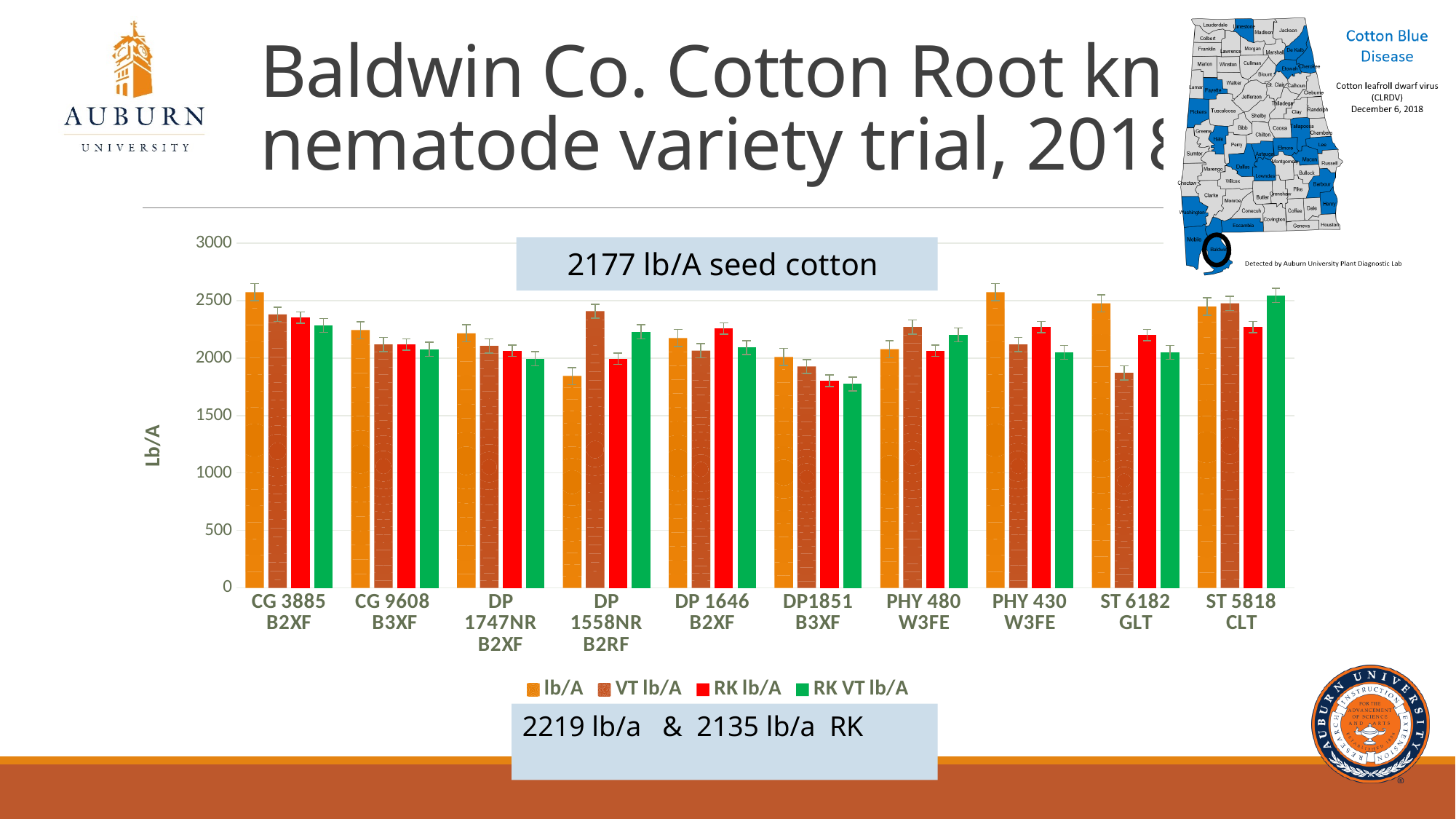
For DP 1558NR B2RF, which is larger: the lb/A value or the VT lb/A value? VT lb/A How many series does the legend list? 4 What kind of chart is shown on the slide? bar chart Which variety has the lowest RK VT lb/A value? DP1851 B3XF What is the label on the y axis? Lb/A Which variety has the lowest lb/A value? DP 1558NR B2RF Is the VT lb/A value for ST 6182 GLT greater or less than 2000? less Is the lb/A value for CG 3885 B2XF greater or less than 2500? greater How many cotton varieties are shown along the x axis? 10 Is the RK VT lb/A value for DP1851 B3XF greater or less than 2000? less Which series is shown in green in the legend? RK VT lb/A